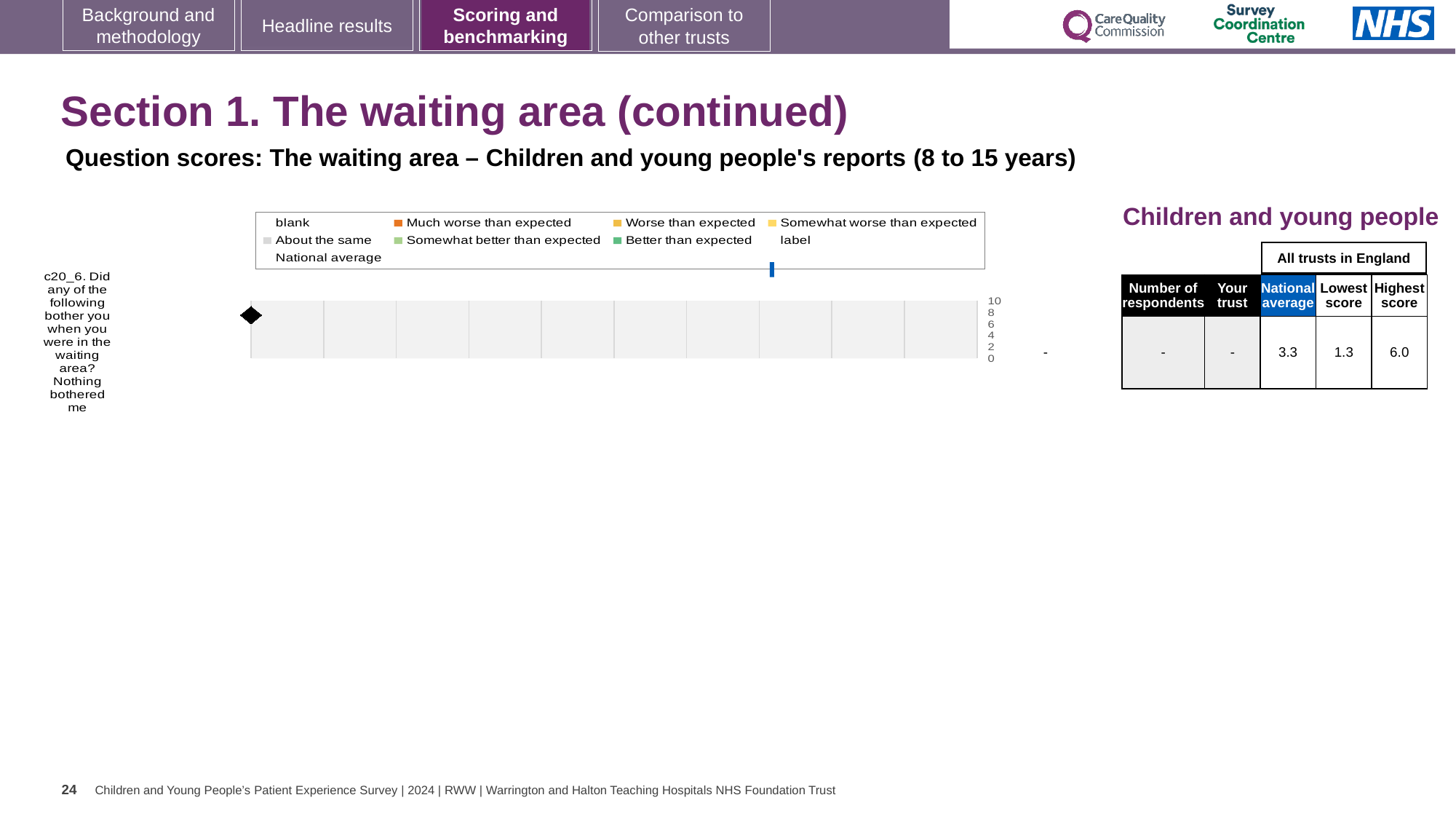
What is the question label shown on the chart's category axis? c20_6. Did any of the following bother you when you were in the waiting area? Nothing bothered me Which is larger for question c20_6: the National average or the Lowest score? National average In the table next to the chart, what is the Highest score among all trusts in England for question c20_6? 6.0 In the table next to the chart, what is the National average score for question c20_6? 3.3 What is the highest tick value shown on the chart's value axis? 10 What value is shown for 'Your trust' in the table for question c20_6? - In the table next to the chart, what is the Lowest score among all trusts in England for question c20_6? 1.3 What is the difference between the Highest score and the Lowest score shown in the table for question c20_6? 4.7 What kind of chart is shown on the slide? bar chart How many question categories are plotted on the chart? 1 What value is shown for 'Number of respondents' in the table for question c20_6? -